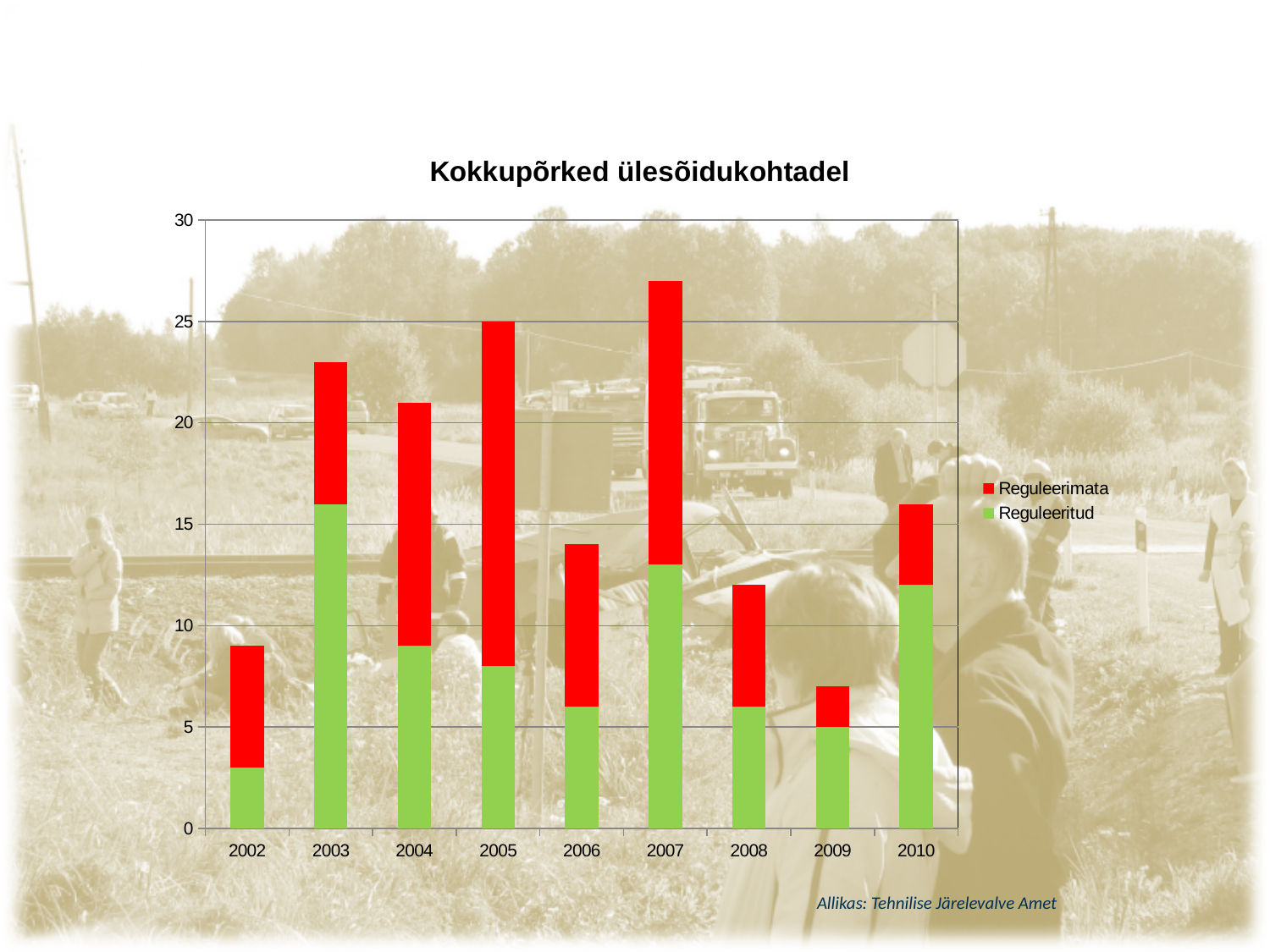
What kind of chart is shown on the slide? stacked bar chart Which year has the shortest total bar? 2009 How many years are shown on the x axis? 9 What is the title of the chart? Kokkupõrked ülesõidukohtadel Is the total for 2003 greater or less than 20? greater Do the total bar heights rise or fall from 2007 to 2009? fall Which year has the largest Reguleeritud (green) value? 2003 Which year has the smallest Reguleeritud (green) value? 2002 Which year has the tallest total bar? 2007 What is the total height of the stacked bar for 2005? 25 What is the Reguleeritud value for 2009? 5 How many series does the legend list? 2